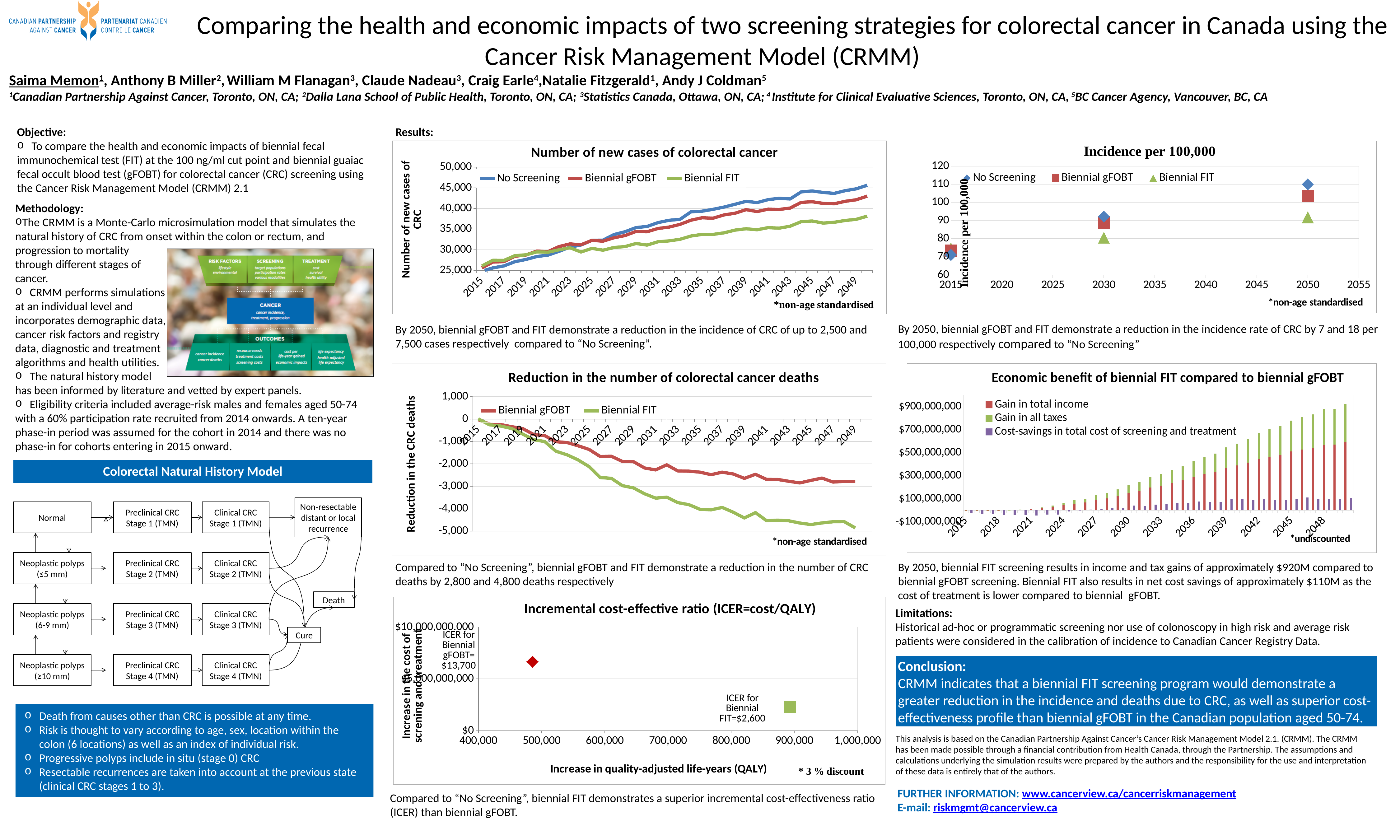
In the 'Incidence per 100,000' chart, which series has the highest value in 2050? No Screening In the 'Incidence per 100,000' chart, is the Biennial FIT value in 2030 greater or less than 90? less In the 'Number of new cases of colorectal cancer' chart, does the No Screening series rise or fall from 2015 to 2049? rise How many series does the legend of the 'Number of new cases of colorectal cancer' chart list? 3 In the 'Incremental cost-effective ratio (ICER=cost/QALY)' chart, what is the ICER for Biennial gFOBT? $13,700 In the 'Number of new cases of colorectal cancer' chart, which series is higher in 2049: No Screening or Biennial FIT? No Screening How many series does the legend of the 'Reduction in the number of colorectal cancer deaths' chart list? 2 What kind of chart is the 'Economic benefit of biennial FIT compared to biennial gFOBT' chart? bar chart What kind of chart is the 'Number of new cases of colorectal cancer' chart? line chart In the 'Reduction in the number of colorectal cancer deaths' chart, does the Biennial FIT series rise or fall from 2015 to 2049? fall In the 'Number of new cases of colorectal cancer' chart, is the Biennial FIT value in 2049 greater or less than 40,000? less In the 'Incremental cost-effective ratio (ICER=cost/QALY)' chart, what is the ICER for Biennial FIT? $2,600